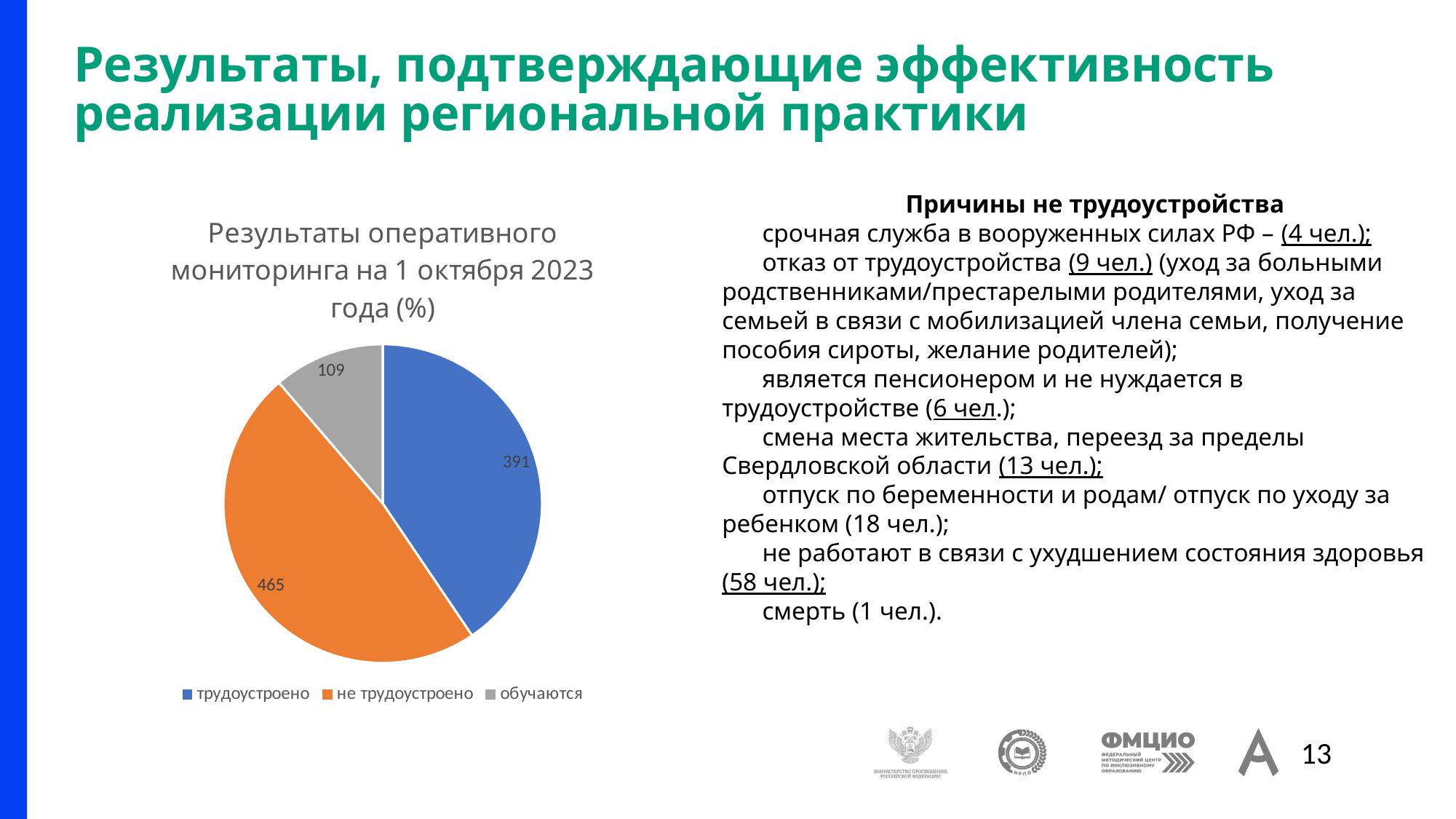
Which category has the largest slice in the pie chart? не трудоустроено What type of chart is shown on the slide? pie chart Which colour represents "не трудоустроено" in the pie chart? orange What is the difference between the "не трудоустроено" and "трудоустроено" values in the pie chart? 74 What value is shown for the "не трудоустроено" slice of the pie chart? 465 Which is larger in the pie chart: "трудоустроено" or "обучаются"? трудоустроено How many slices does the pie chart have? 3 What value is shown for the "обучаются" slice of the pie chart? 109 What is the title of the chart on the slide? Результаты оперативного мониторинга на 1 октября 2023 года (%) Which category has the smallest slice in the pie chart? обучаются How many entries does the legend of the pie chart list? 3 What value is shown for the "трудоустроено" slice of the pie chart? 391